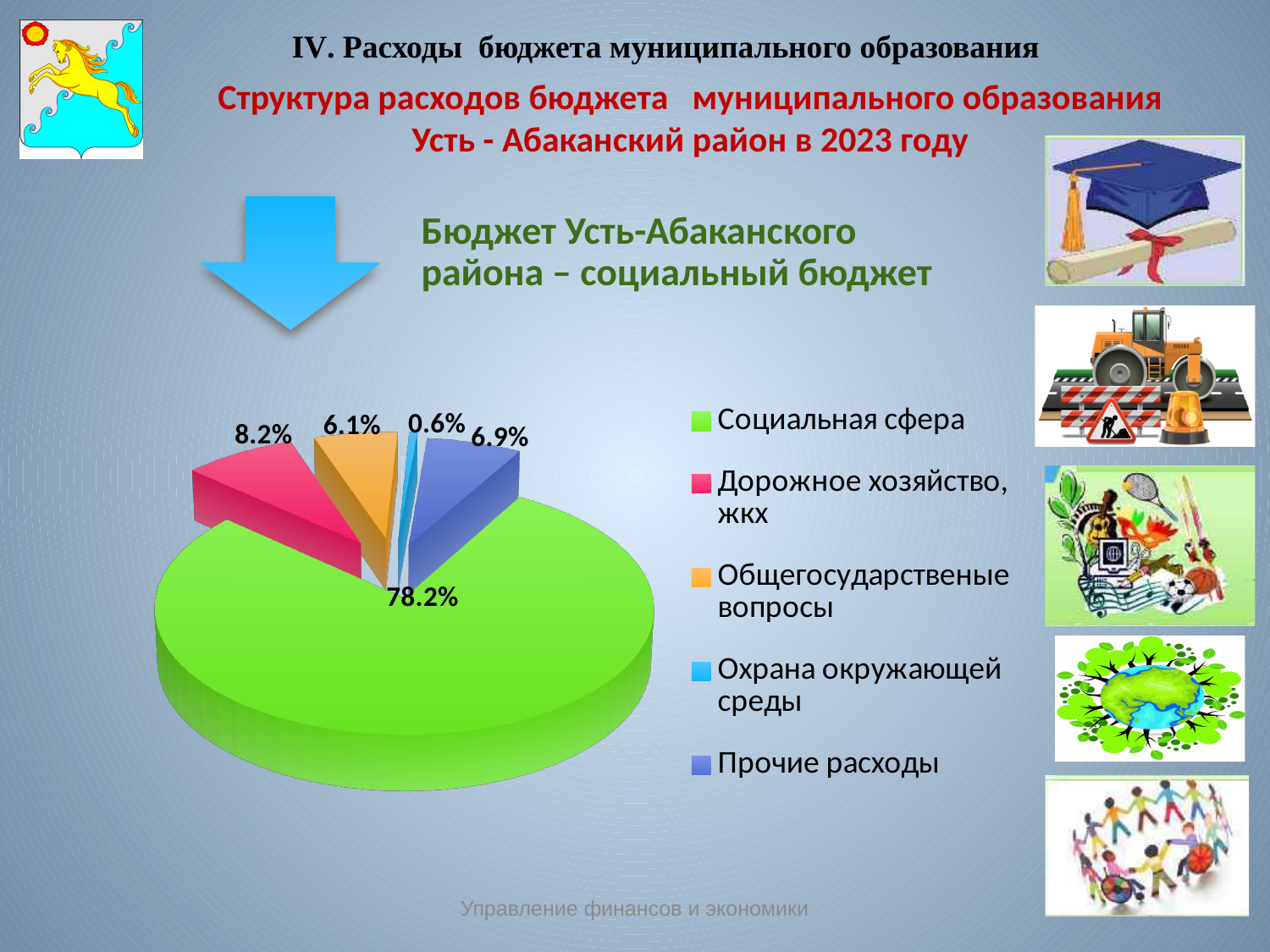
What is the difference between the shares of Социальная сфера and Дорожное хозяйство, жкх? 70.0% What kind of chart is shown on the slide? pie chart What is the value for Охрана окружающей среды? 0.6% What colour is the slice for Социальная сфера? green What share of the budget expenditure goes to Социальная сфера? 78.2% What is the value for Общегосударственые вопросы? 6.1% What is the value for Дорожное хозяйство, жкх? 8.2% Which category has the smallest share of the pie? Охрана окружающей среды Which category has the largest share of the pie? Социальная сфера What is the value for Прочие расходы? 6.9% Which is larger: Дорожное хозяйство, жкх or Прочие расходы? Дорожное хозяйство, жкх How many categories does the pie chart have? 5